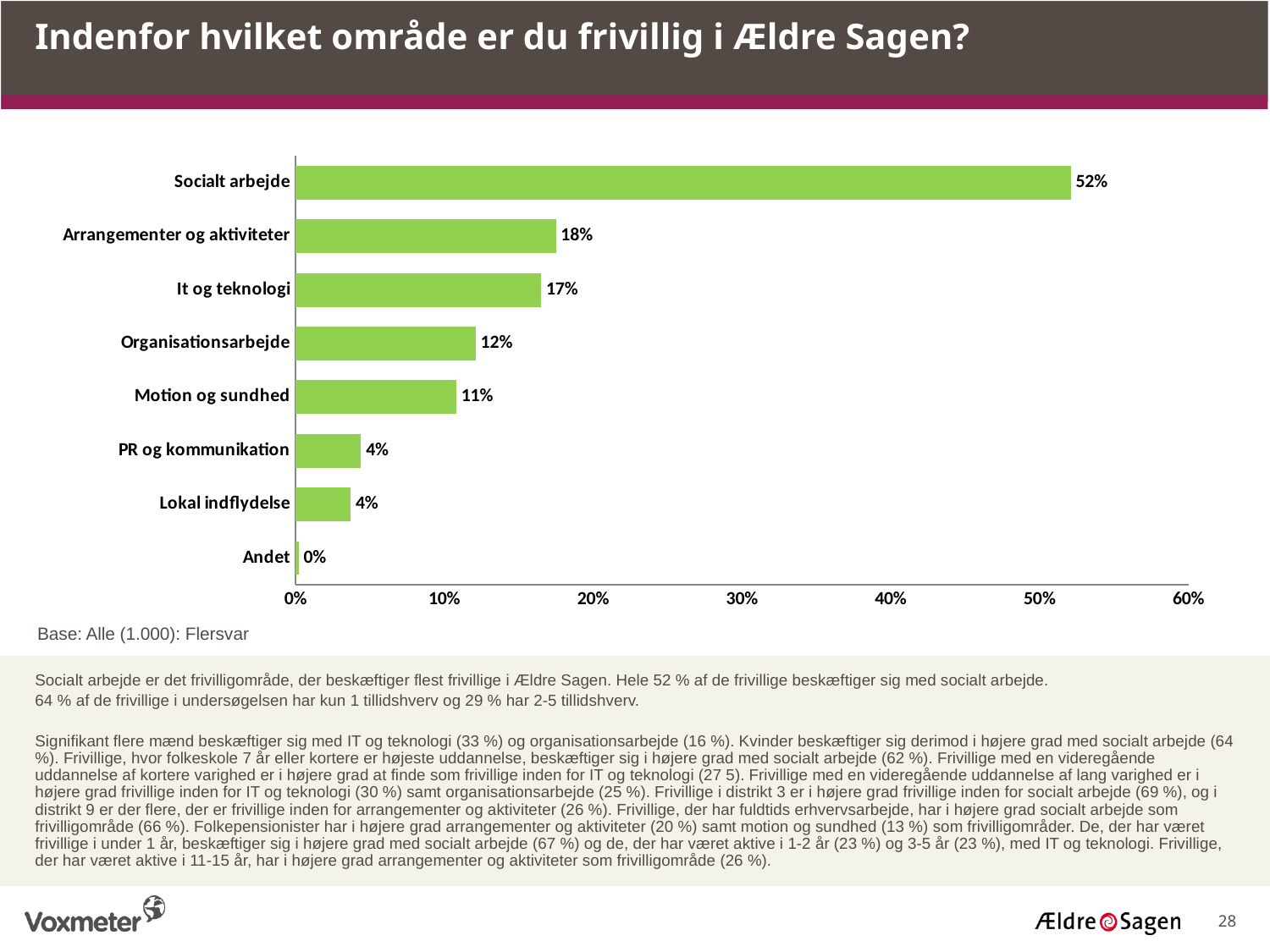
What is the value for It og teknologi? 17% Which category has the highest value? Socialt arbejde What is the difference between Socialt arbejde and Arrangementer og aktiviteter? 34% How many categories are shown in the chart? 8 Is the value for Socialt arbejde greater or less than 50%? greater What is the value for Motion og sundhed? 11% What kind of chart is shown on the slide? Bar chart What is the value for Socialt arbejde? 52% What is the difference between Organisationsarbejde and PR og kommunikation? 8% What is the title of the chart? Indenfor hvilket område er du frivillig i Ældre Sagen? Which category has the lowest value? Andet Which is larger, Arrangementer og aktiviteter or Organisationsarbejde? Arrangementer og aktiviteter